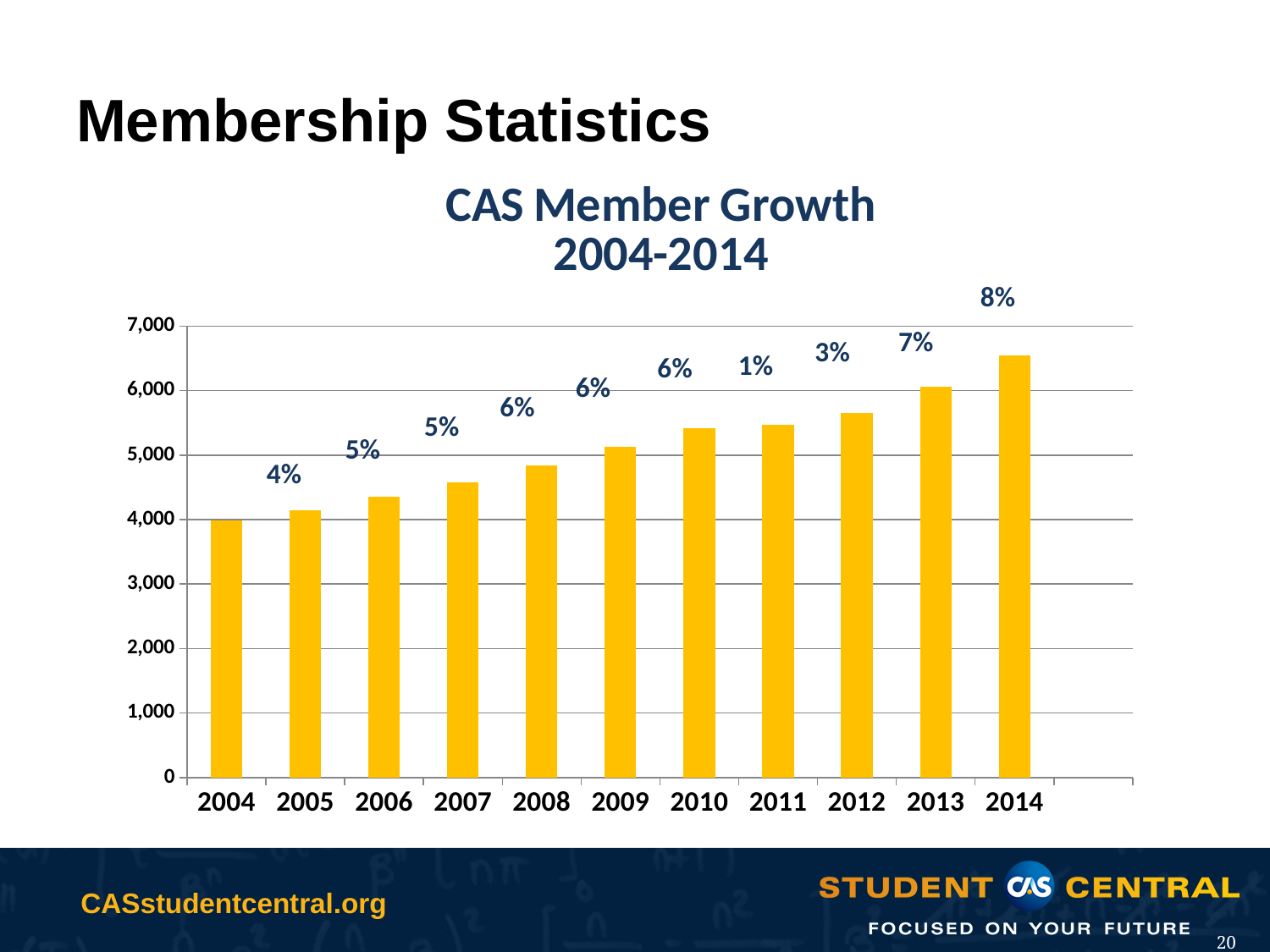
Is the value for 2008 greater or less than 5,000? less Which year has the shortest bar in the chart? 2004 What growth percentage is labeled above the 2011 bar? 1% Which year has the lowest growth percentage label? 2011 What type of chart is shown on the slide? Bar chart Which year has the tallest bar in the chart? 2014 What growth percentage is labeled above the 2005 bar? 4% What is the title of the chart? CAS Member Growth 2004-2014 How many years (bars) are plotted in the chart? 11 What growth percentage is labeled above the 2014 bar? 8% Is the value for 2014 greater or less than 6,000? greater Do the bar values generally rise or fall from 2004 to 2014? Rise